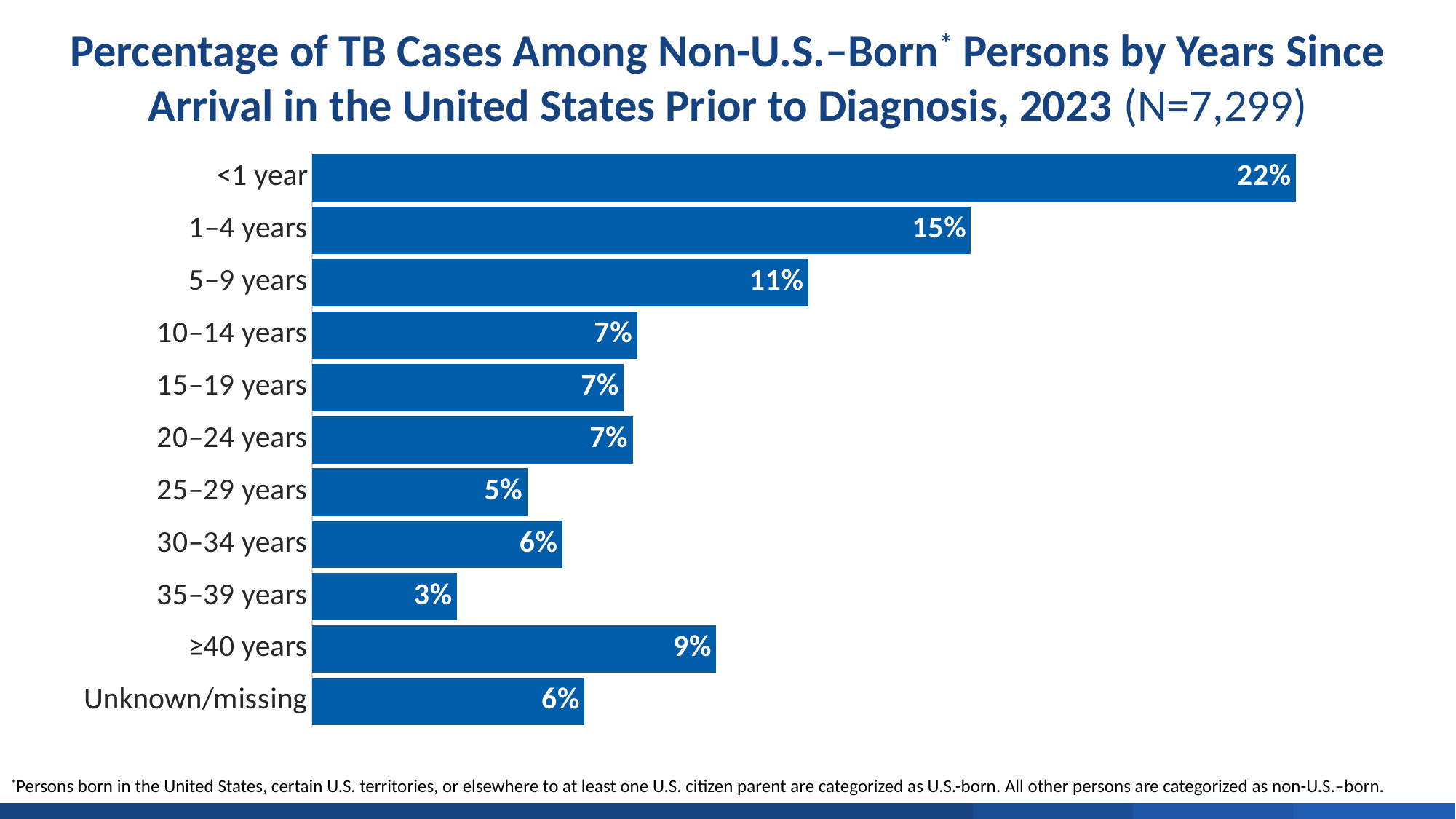
Which category has the highest percentage of TB cases? <1 year What percentage is shown for the ≥40 years category? 9% What is the value for the 5–9 years category? 11% What is the value for Unknown/missing? 6% What kind of chart is shown on the slide? Bar chart What is the total N given in the chart title? 7,299 Which is larger, the value for 25–29 years or the value for 30–34 years? 30–34 years How many categories are shown in the chart? 11 Which category has the lowest percentage of TB cases? 35–39 years What percentage of TB cases among non-U.S.-born persons were diagnosed less than 1 year after arrival? 22% What is the difference between the <1 year and 1–4 years percentages? 7% What is the difference between the ≥40 years value and the 35–39 years value? 6%